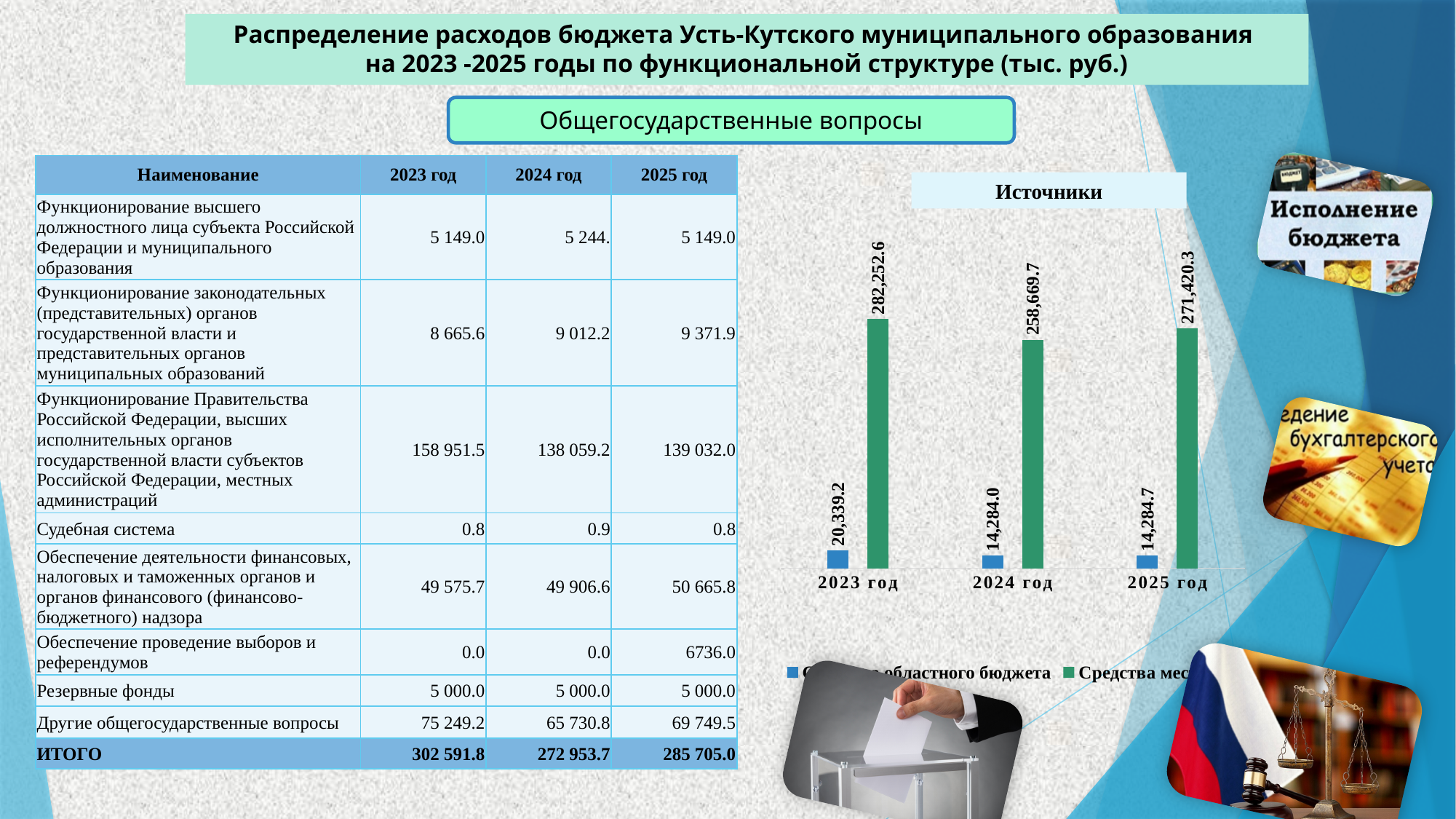
In the "Источники" chart, what is the value of the blue bar for 2024 год? 14,284.0 In the "Источники" chart, does the green series rise or fall from 2023 год to 2024 год? fall What type of chart is shown under the title "Источники"? bar chart How many year categories are shown on the x axis of the "Источники" chart? 3 In the "Источники" chart, is the green bar larger for 2024 год or for 2025 год? 2025 год In the "Источники" chart, what is the value of the green bar for 2023 год? 282,252.6 In the "Источники" chart, which year has the lowest green bar? 2024 год What is the title of the chart on the right side of the slide? Источники In the "Источники" chart, what is the difference between the green and blue bars for 2023 год? 261,913.4 In the "Источники" chart, which year has the highest green bar? 2023 год In the "Источники" chart, what is the value of the green bar for 2025 год? 271,420.3 How many series does the legend of the "Источники" chart list? 2